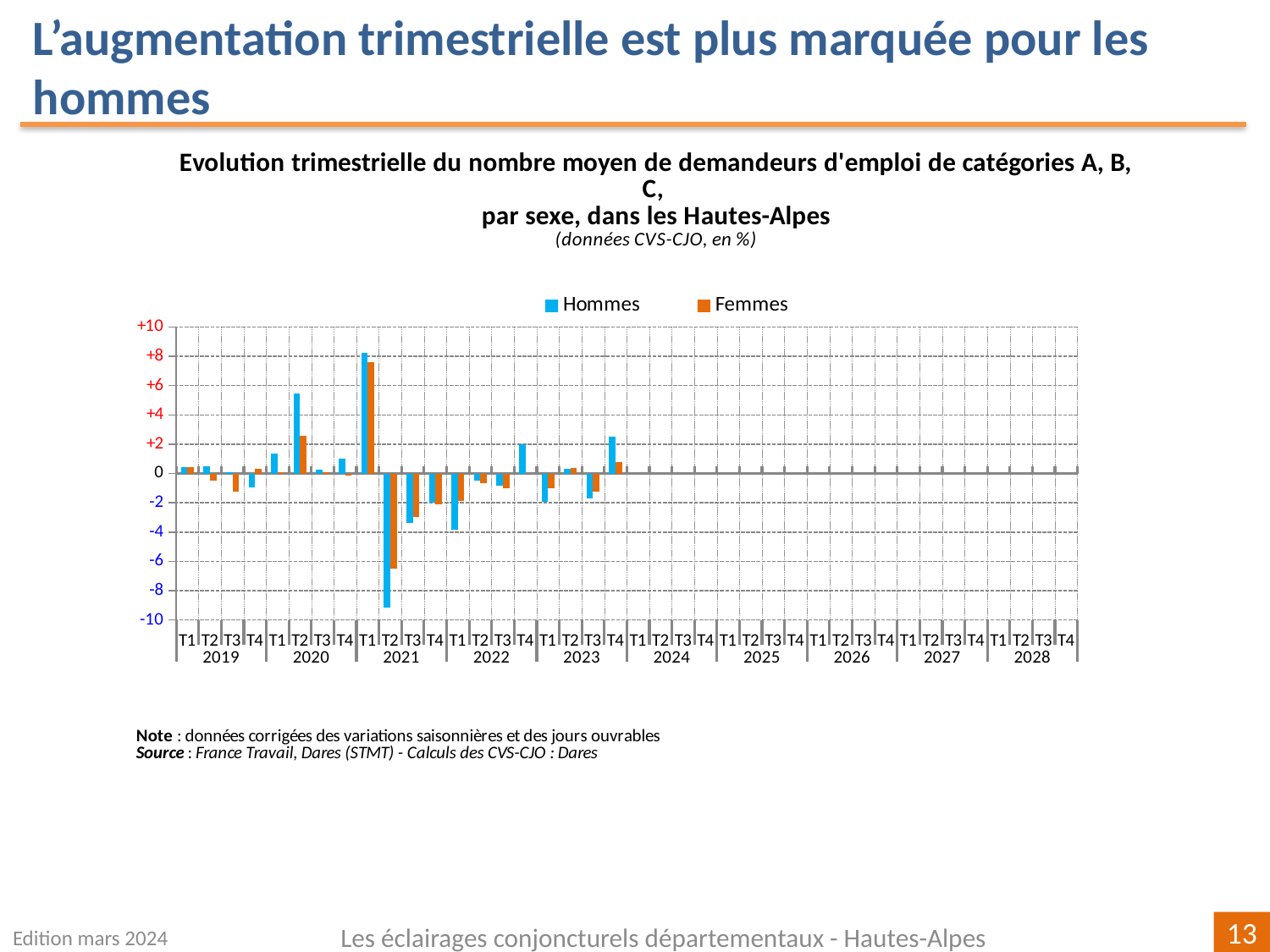
How many years are labelled along the x axis? 10 What kind of chart is shown on the slide? bar chart In which quarter does the Hommes series reach its highest value? T1 2021 What are the two series named in the legend? Hommes and Femmes Is the Hommes value for T1 2021 greater or less than +6? greater In T2 2020, which series has the larger value, Hommes or Femmes? Hommes Is the Hommes value for T2 2020 greater or less than +4? greater In which quarter does the Femmes series reach its highest value? T1 2021 Is the Hommes value for T2 2021 greater or less than -8? less In which quarter does the Hommes series reach its lowest value? T2 2021 How many series does the legend list? 2